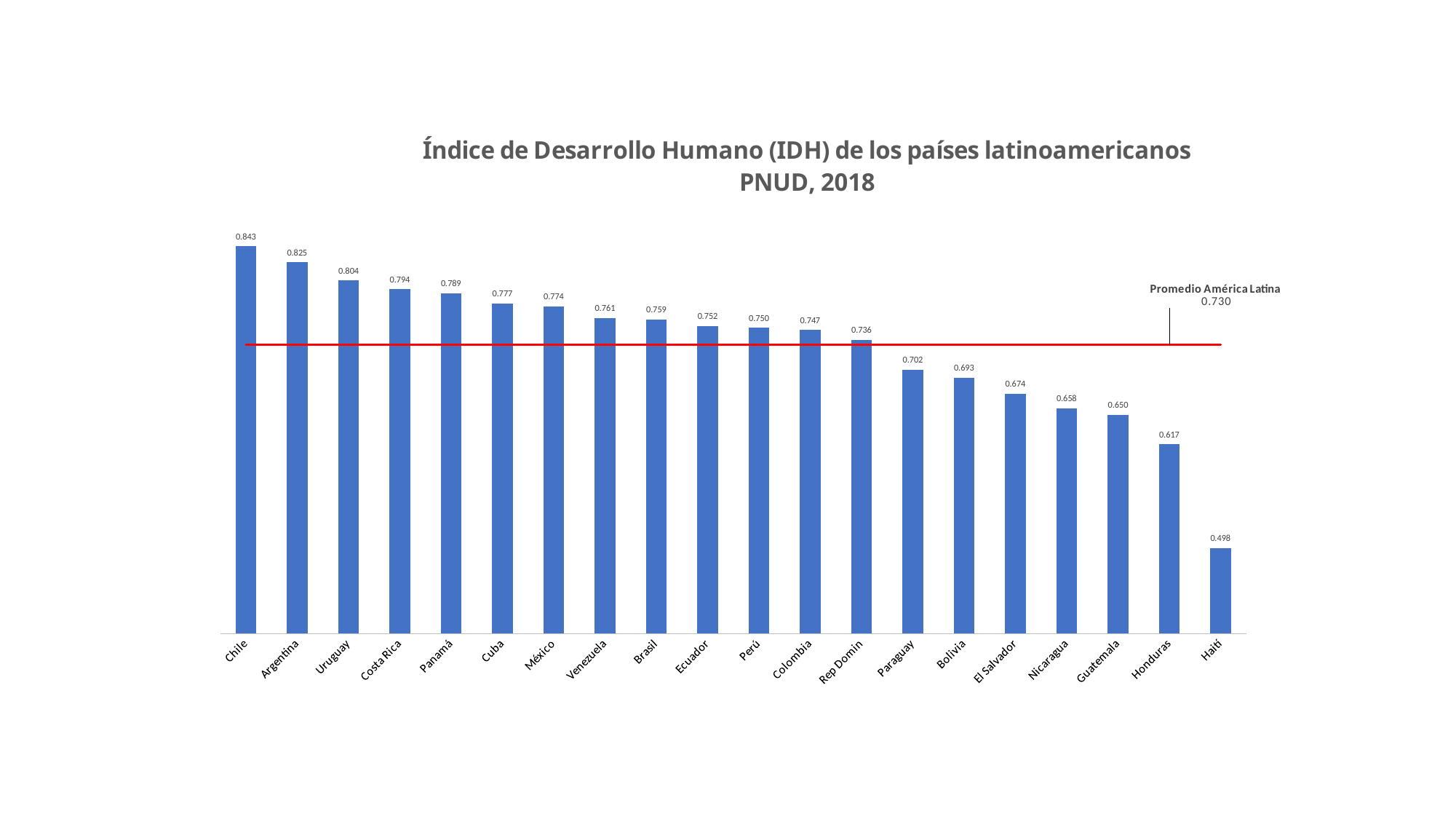
What is the difference between the IDH values of Chile and Haití? 0.345 What is the IDH value for Colombia? 0.747 Do the IDH values rise or fall from left to right along the x axis? Fall What is the difference between the IDH values of Argentina and Uruguay? 0.021 What value does the red line labelled 'Promedio América Latina' mark? 0.730 Which has a higher IDH value, Paraguay or Bolivia? Paraguay What is the IDH value for Haití? 0.498 How many countries are shown in the chart? 20 Which country has the highest IDH value? Chile Which country has the lowest IDH value? Haití What is the IDH value for Chile? 0.843 What kind of chart is shown on the slide? Bar chart